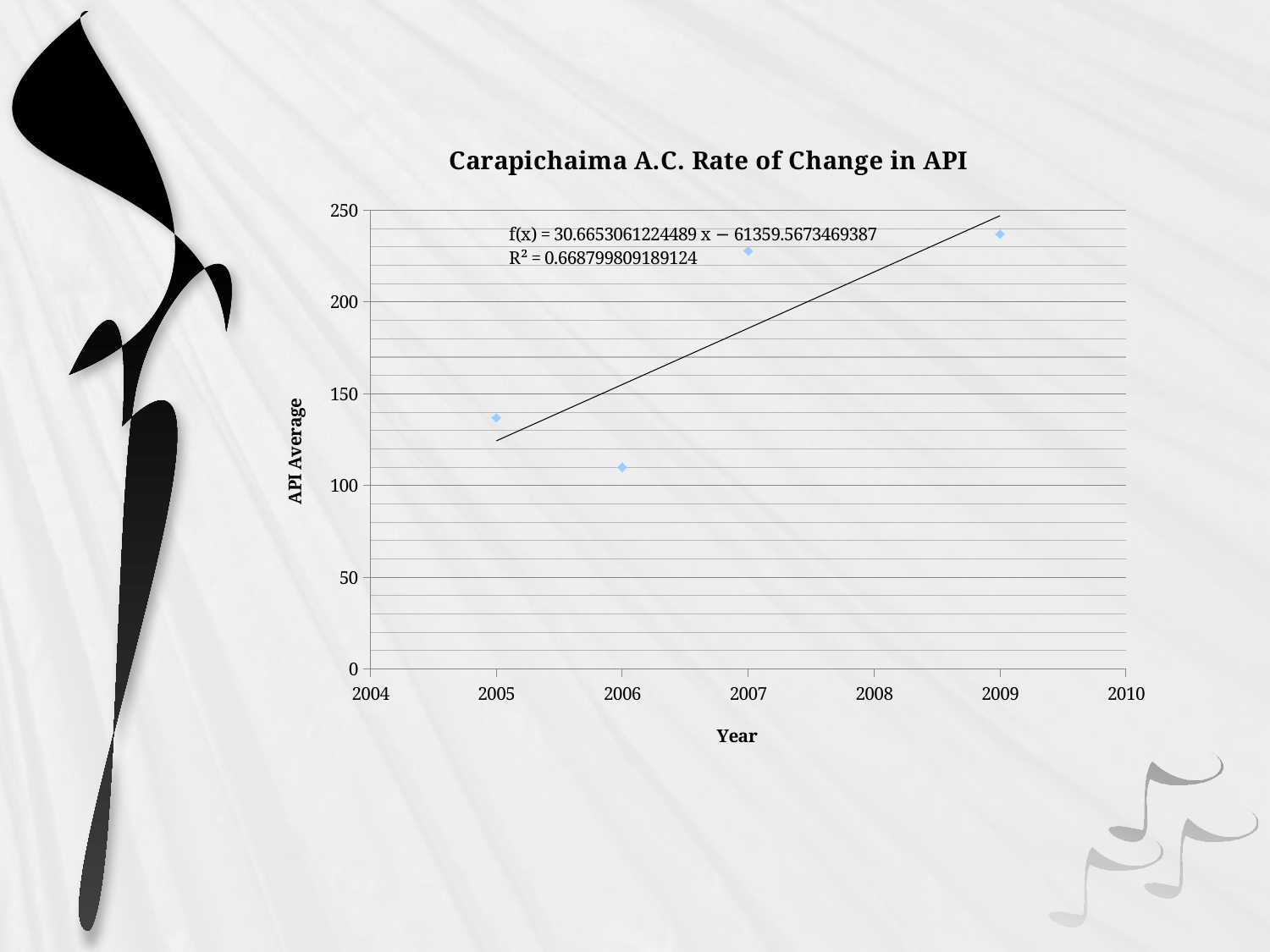
Is the API Average for 2007 greater or less than 200? greater What is the label of the y axis? API Average Which year has the larger API Average, 2005 or 2006? 2005 Is the API Average for 2009 greater or less than 200? greater What kind of chart is shown on the slide? Scatter chart Which year has the lowest API Average? 2006 What is the title of the chart? Carapichaima A.C. Rate of Change in API What is the R² value shown on the chart? 0.668799809189124 How many data points are plotted on the chart? 4 Which year has the larger API Average, 2007 or 2005? 2007 Is the API Average for 2006 greater or less than 150? less